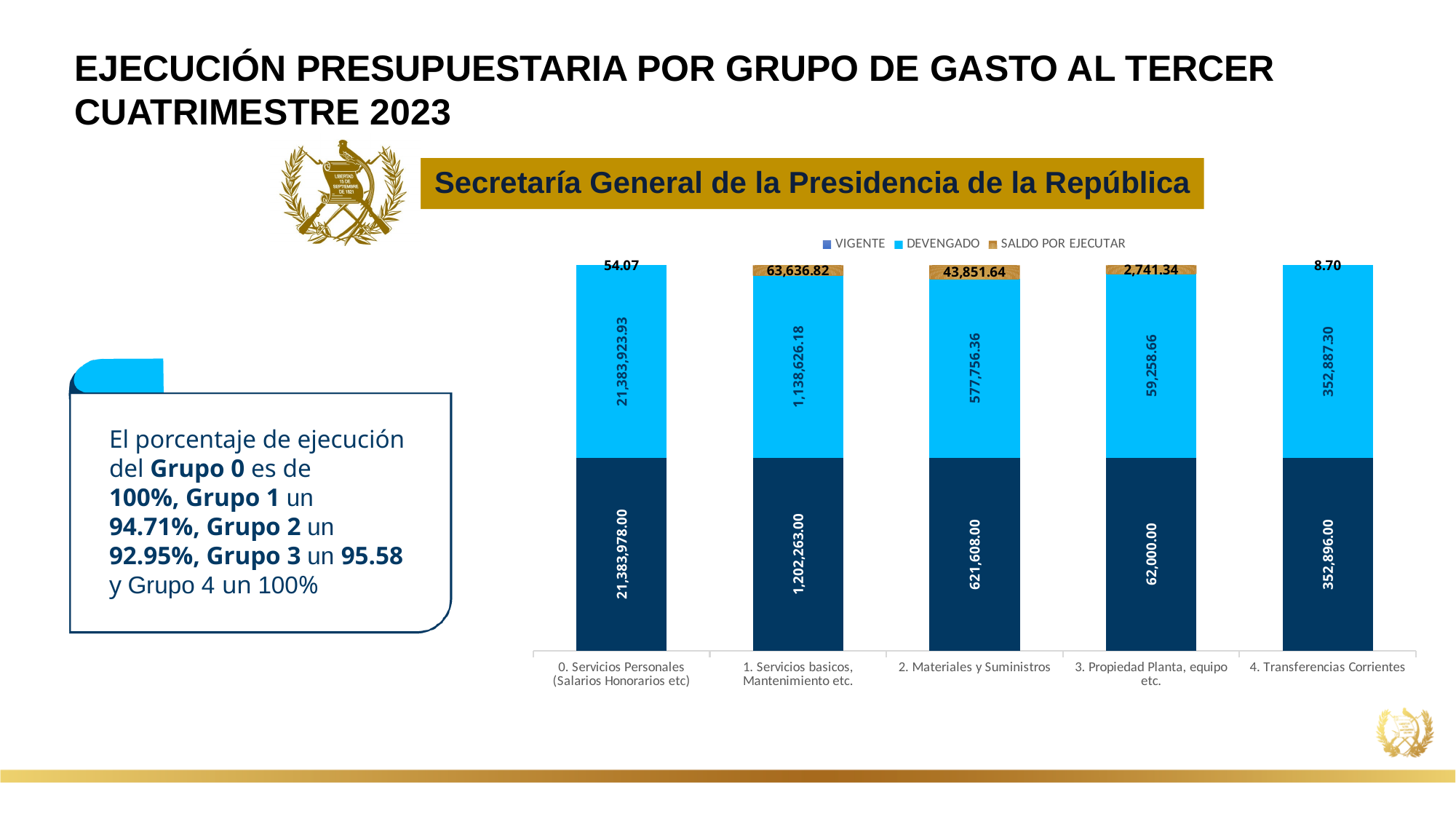
What is the difference between the VIGENTE and DEVENGADO values for '1. Servicios basicos, Mantenimiento etc.'? 63,636.82 What kind of chart is shown on the slide? Stacked bar chart Which series is shown in the dark navy colour at the bottom of each bar? VIGENTE What is the VIGENTE value for '0. Servicios Personales (Salarios Honorarios etc)'? 21,383,978.00 Which category has the lowest VIGENTE value? 3. Propiedad Planta, equipo etc. What is the DEVENGADO value for '4. Transferencias Corrientes'? 352,887.30 How many categories are shown on the x axis of the chart? 5 How many series does the chart legend list? 3 What is the DEVENGADO value for '2. Materiales y Suministros'? 577,756.36 What is the SALDO POR EJECUTAR value for '3. Propiedad Planta, equipo etc.'? 2,741.34 Which category has the highest SALDO POR EJECUTAR value? 1. Servicios basicos, Mantenimiento etc. Which is larger: the VIGENTE value for '2. Materiales y Suministros' or the VIGENTE value for '4. Transferencias Corrientes'? 2. Materiales y Suministros